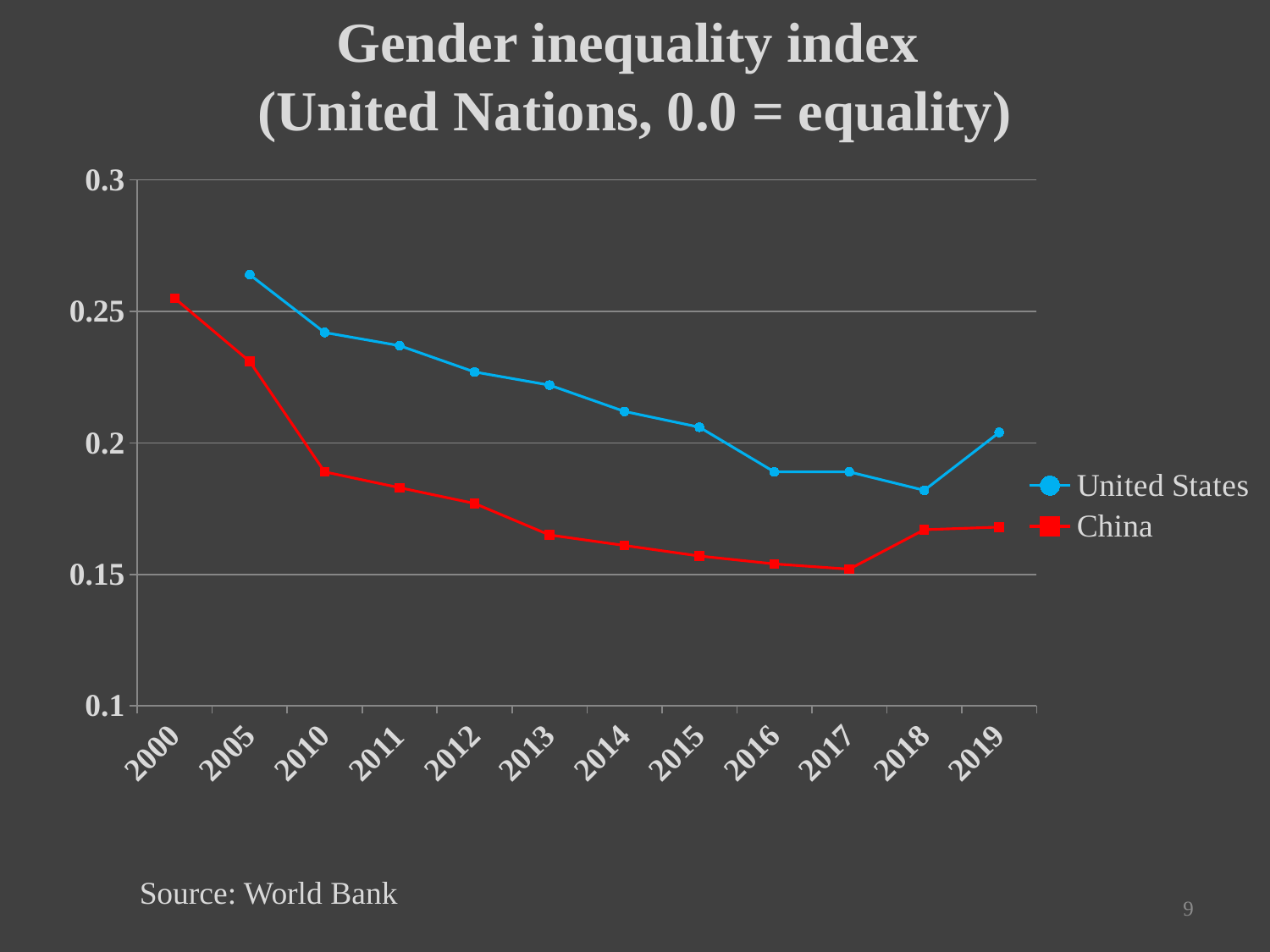
Do the values for China generally rise or fall from 2000 to 2017? fall In which year is the United States series at its lowest? 2018 What kind of chart is shown on the slide? line chart In which year is the China series at its highest? 2000 How many series does the legend list? 2 Which series has the higher value in 2015, United States or China? United States Is the value for China in 2000 greater or less than 0.25? greater What colour is the line for China? red In which year is the United States series at its highest? 2005 Is the value for the United States in 2018 greater or less than 0.2? less Is the value for China in 2012 greater or less than 0.2? less How many years are labelled on the x axis? 12